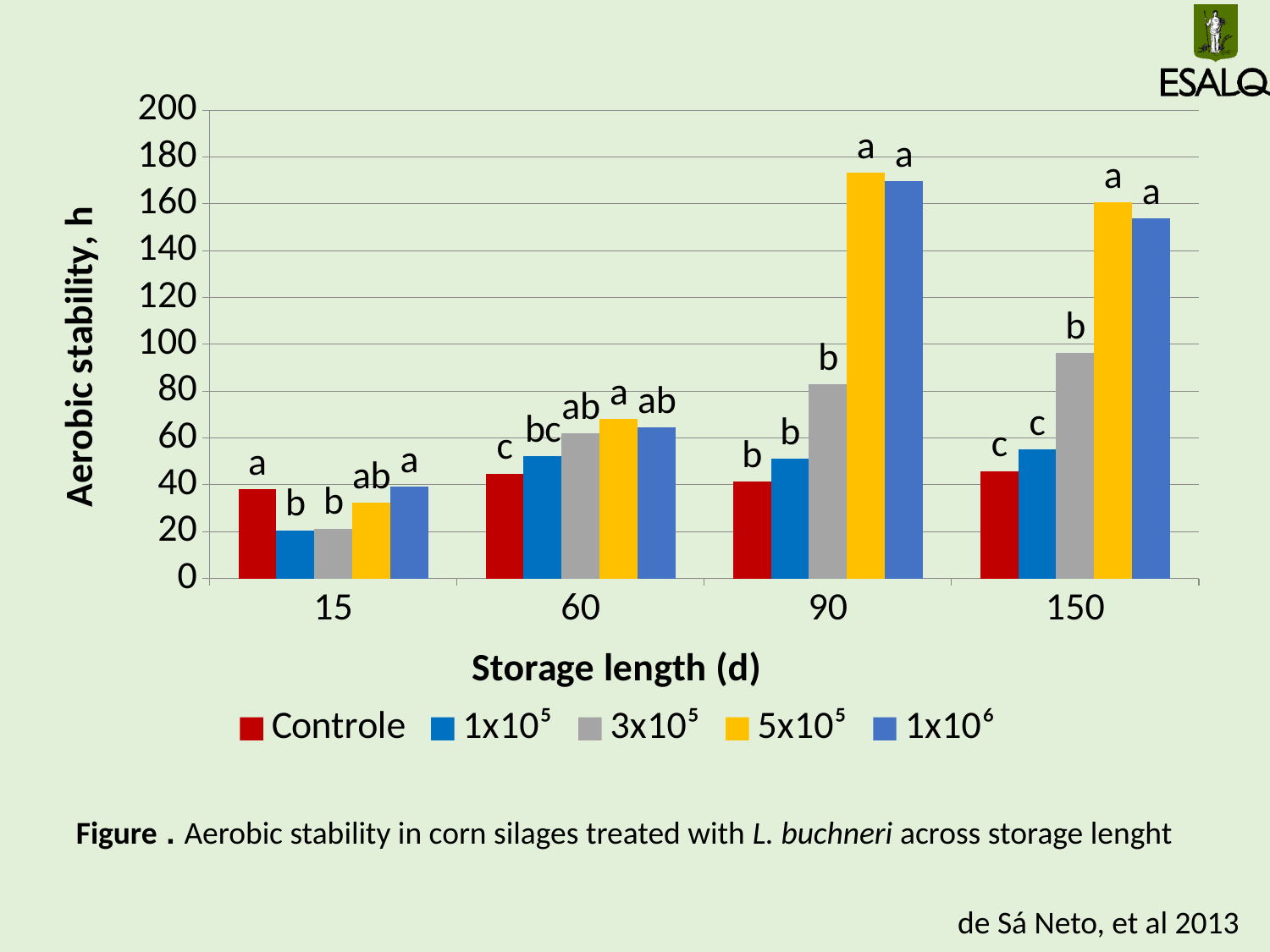
At which storage length is the 5x10⁵ bar highest? 90 Is the value for Controle at 60 d greater or less than 60? less What kind of chart is shown on the slide? bar chart At 90 d, which series has the lowest aerobic stability? Controle Do the 3x10⁵ values rise or fall as storage length increases from 15 to 150 d? rise What is the title of the x axis? Storage length (d) How many series does the legend list? 5 Is the value for 5x10⁵ at 90 d greater or less than 160? greater What is the title of the y axis? Aerobic stability, h How many storage length categories are shown on the x axis? 4 At 90 d, which is larger: the 3x10⁵ bar or the Controle bar? 3x10⁵ Is the value for 3x10⁵ at 150 d greater or less than 80? greater